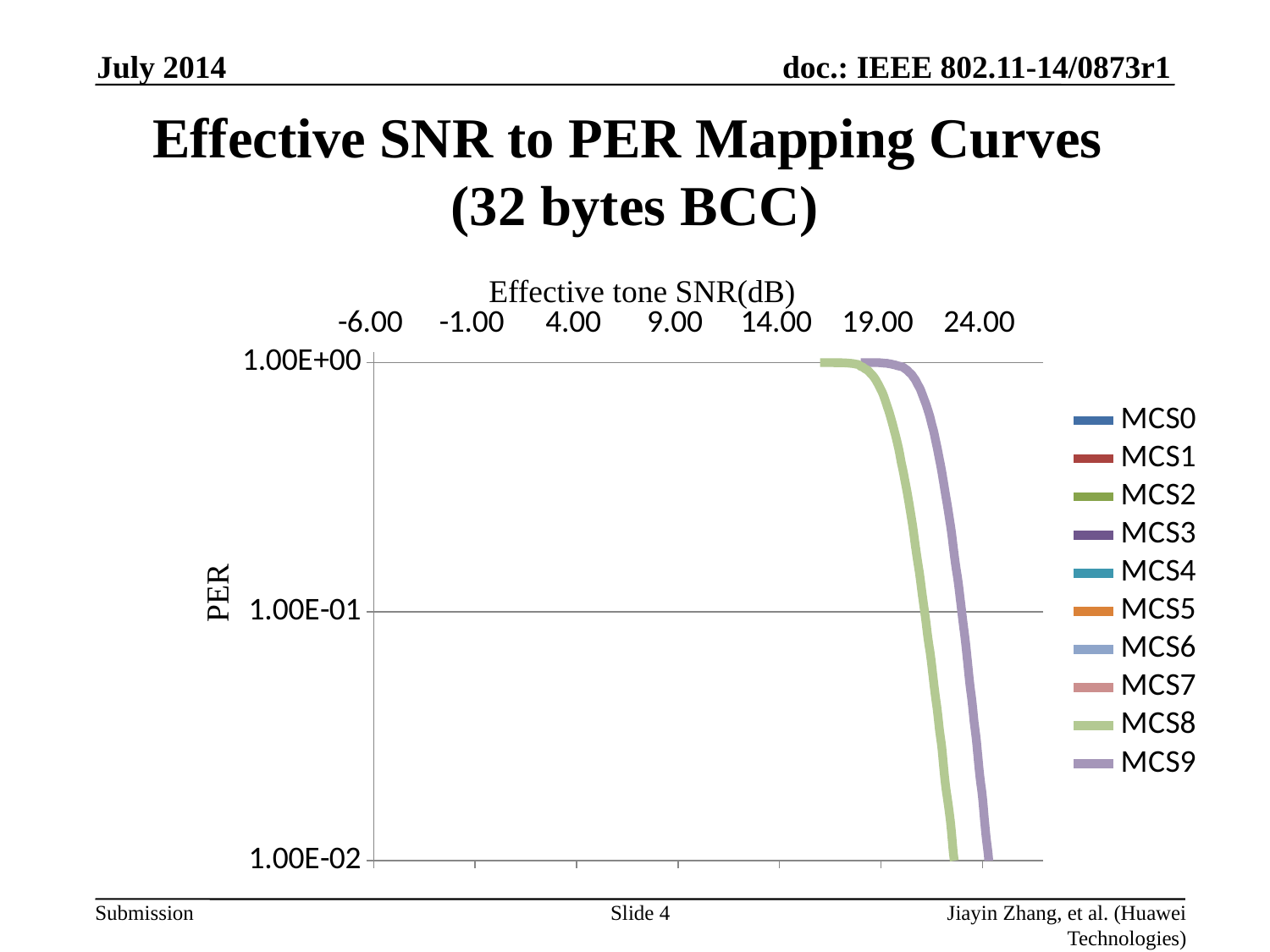
At an effective tone SNR of 19.00 dB, is the PER for MCS9 greater or less than 1.00E-01? greater What kind of chart is shown on the slide? line chart Which curve reaches a PER of 1.00E-01 at a higher effective tone SNR, MCS8 or MCS9? MCS9 What is the label of the y axis of the chart? PER What is the title of the x axis of the chart? Effective tone SNR(dB) Which curve reaches a PER of 1.00E-02 at a lower effective tone SNR, MCS8 or MCS9? MCS8 Which of the two visible curves, MCS8 or MCS9, lies further to the right on the chart? MCS9 At an effective tone SNR of 19.00 dB, is the PER for MCS8 greater or less than 1.00E-01? greater How many series does the legend list? 10 As the effective tone SNR increases along the x axis, do the plotted PER curves rise or fall? fall